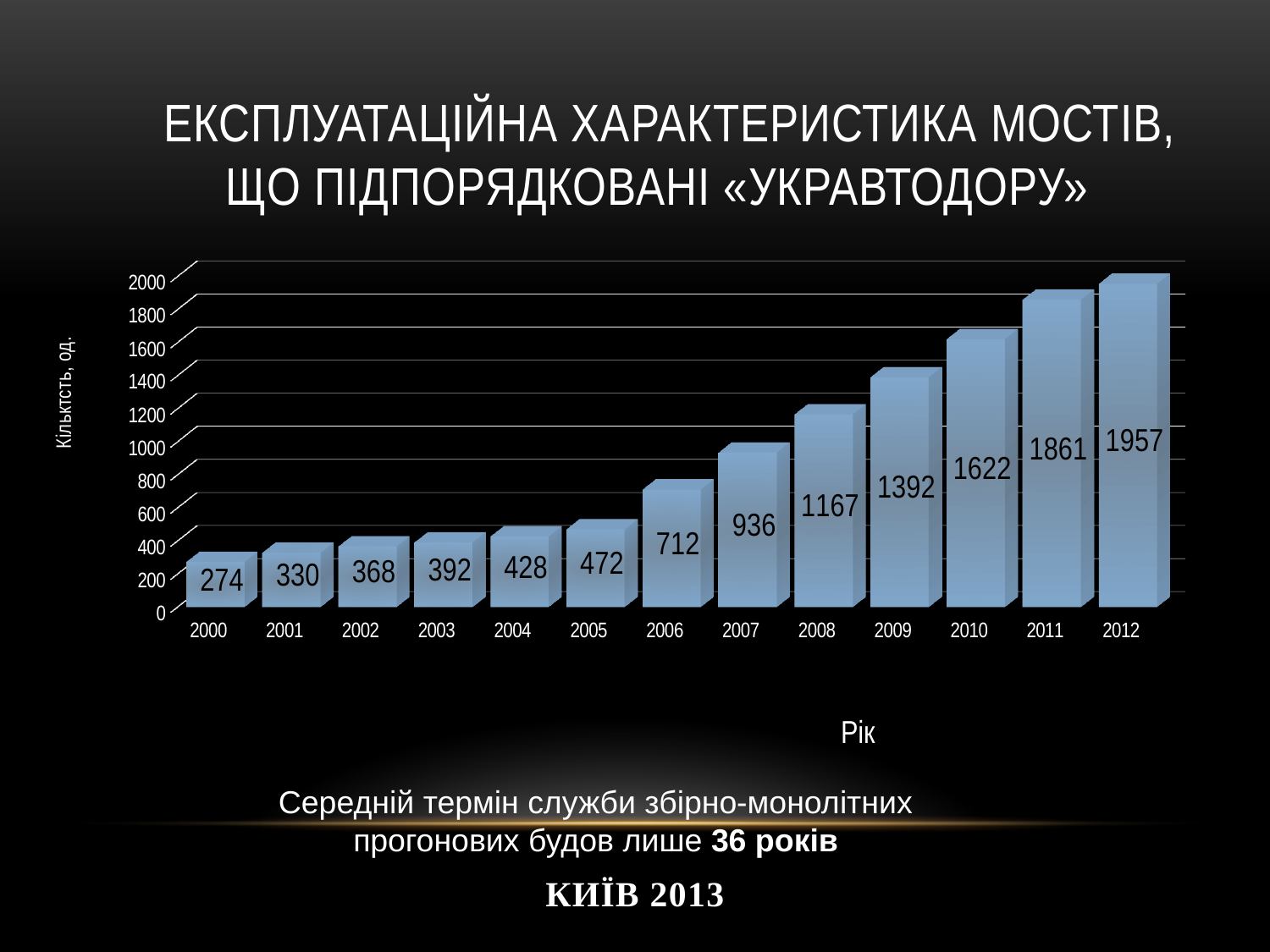
How many years are shown on the x axis? 13 What is the difference between the values for 2008 and 2007? 231 Which is larger, the value for 2009 or the value for 2005? 2009 Do the values rise or fall from 2000 to 2012? rise What kind of chart is shown on the slide? bar chart What is the label of the x axis? Рік What is the value for 2010? 1622 What is the difference between the values for 2012 and 2011? 96 Which year has the lowest value? 2000 What is the value for 2006? 712 What is the value for 2000? 274 Which year has the highest value? 2012